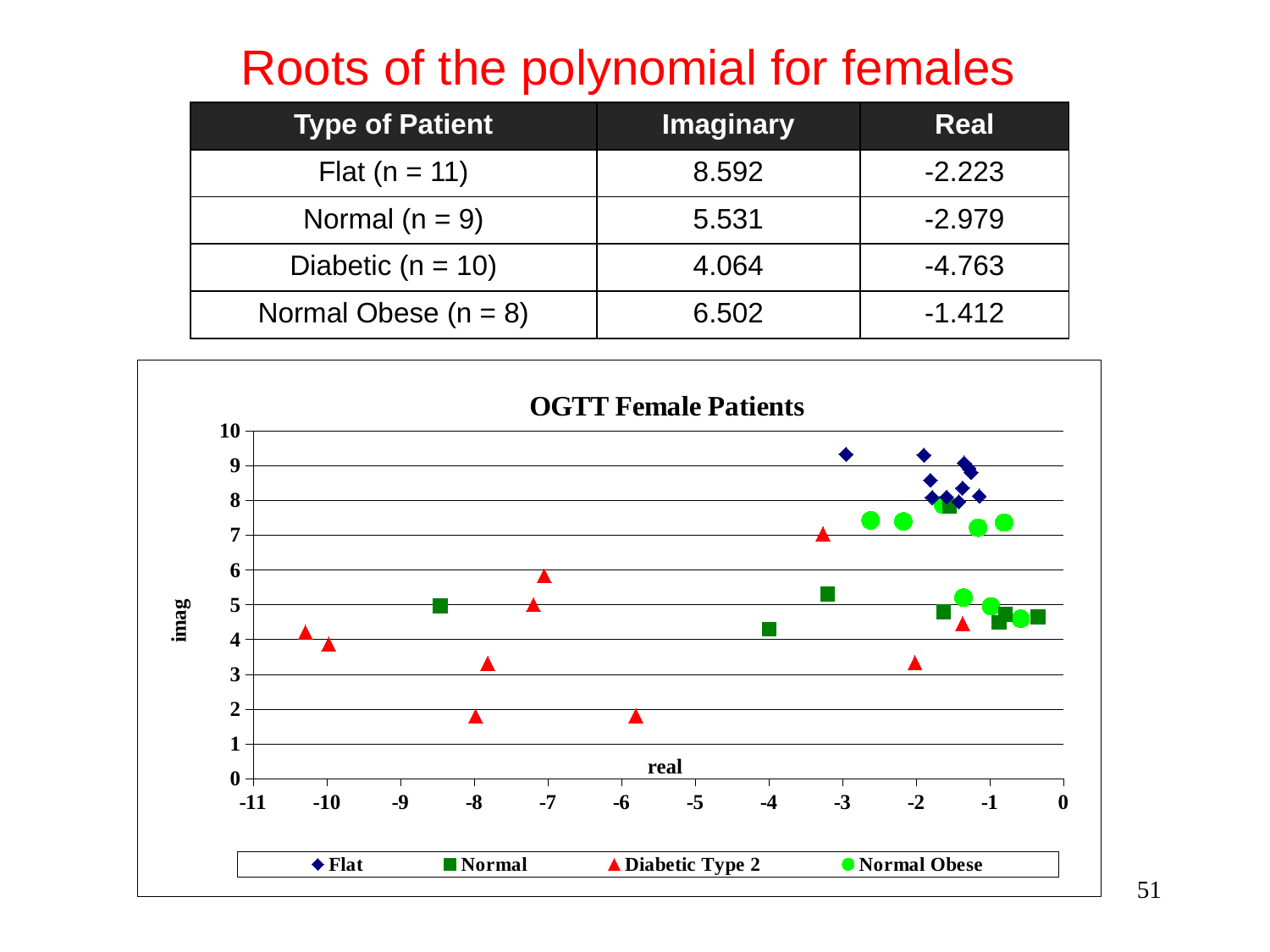
In the OGTT Female Patients chart, is the imag value of the lowest Diabetic Type 2 point greater or less than 2? less How many series does the legend of the OGTT Female Patients chart list? 4 Which series in the OGTT Female Patients chart is plotted with red triangles? Diabetic Type 2 What is the label on the vertical axis of the OGTT Female Patients chart? imag What is the title of the chart on the slide? OGTT Female Patients In the OGTT Female Patients chart, is the real value of the leftmost Normal point greater or less than -8? less In the OGTT Female Patients chart, is the real value of the leftmost Diabetic Type 2 point greater or less than -10? less In the OGTT Female Patients chart, which series has the point with the lowest real value? Diabetic Type 2 What kind of chart is the OGTT Female Patients chart? scatter chart In the OGTT Female Patients chart, which series contains the point with the highest imag value? Flat